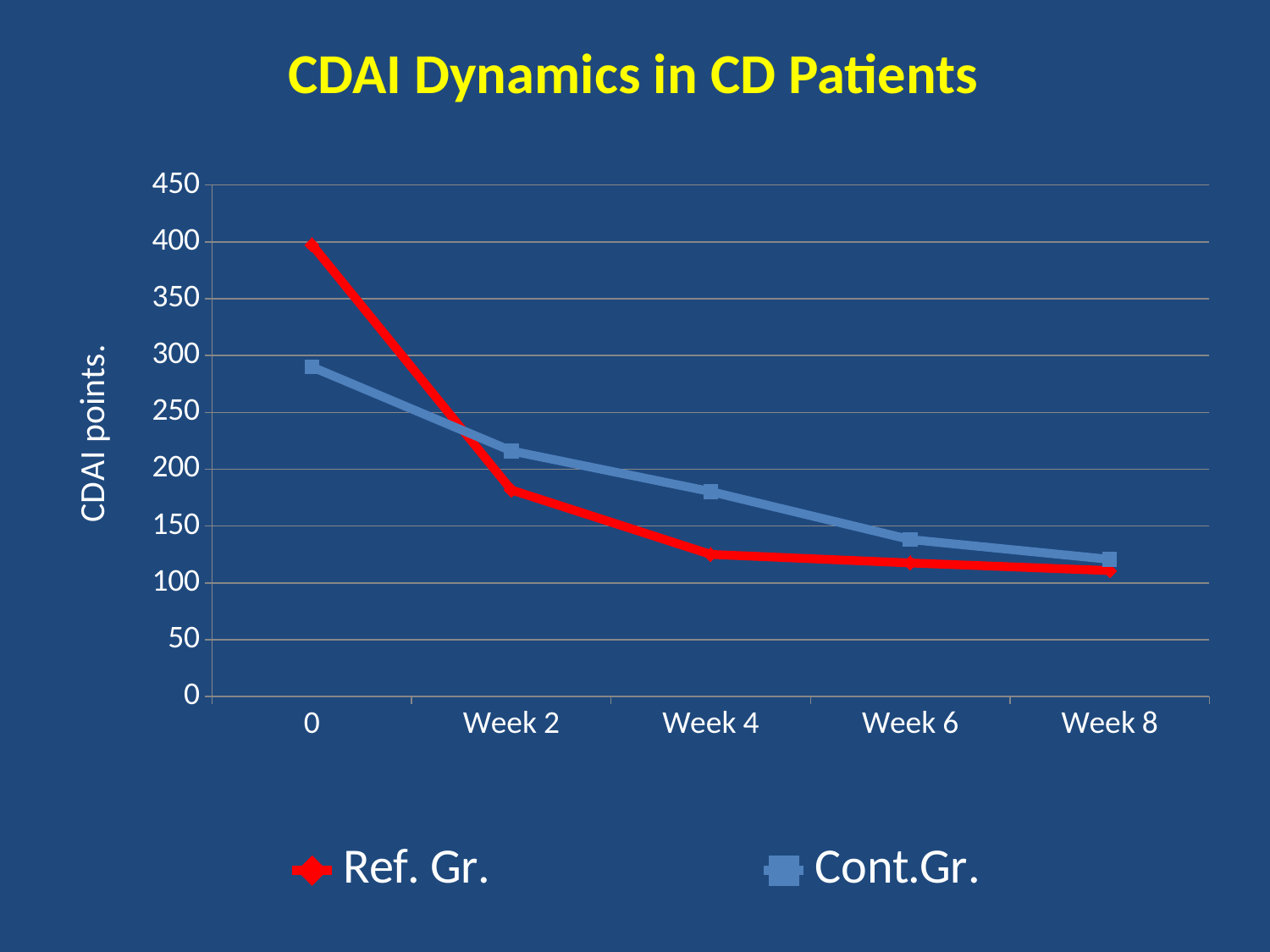
How many time points are plotted along the x axis? 5 What is the title of the chart? CDAI Dynamics in CD Patients At Week 4, which series has the larger value, Ref. Gr. or Cont.Gr.? Cont.Gr. What kind of chart is shown on the slide? line chart Do the values for Cont.Gr. rise or fall from 0 to Week 8? fall Is the value for Ref. Gr. at Week 2 greater or less than 200? less What is the label on the vertical axis? CDAI points. At which time point is the value for Ref. Gr. highest? 0 Do the values for Ref. Gr. rise or fall from 0 to Week 8? fall How many series does the legend list? 2 At time point 0, which series has the larger value, Ref. Gr. or Cont.Gr.? Ref. Gr. At which time point is the value for Cont.Gr. lowest? Week 8